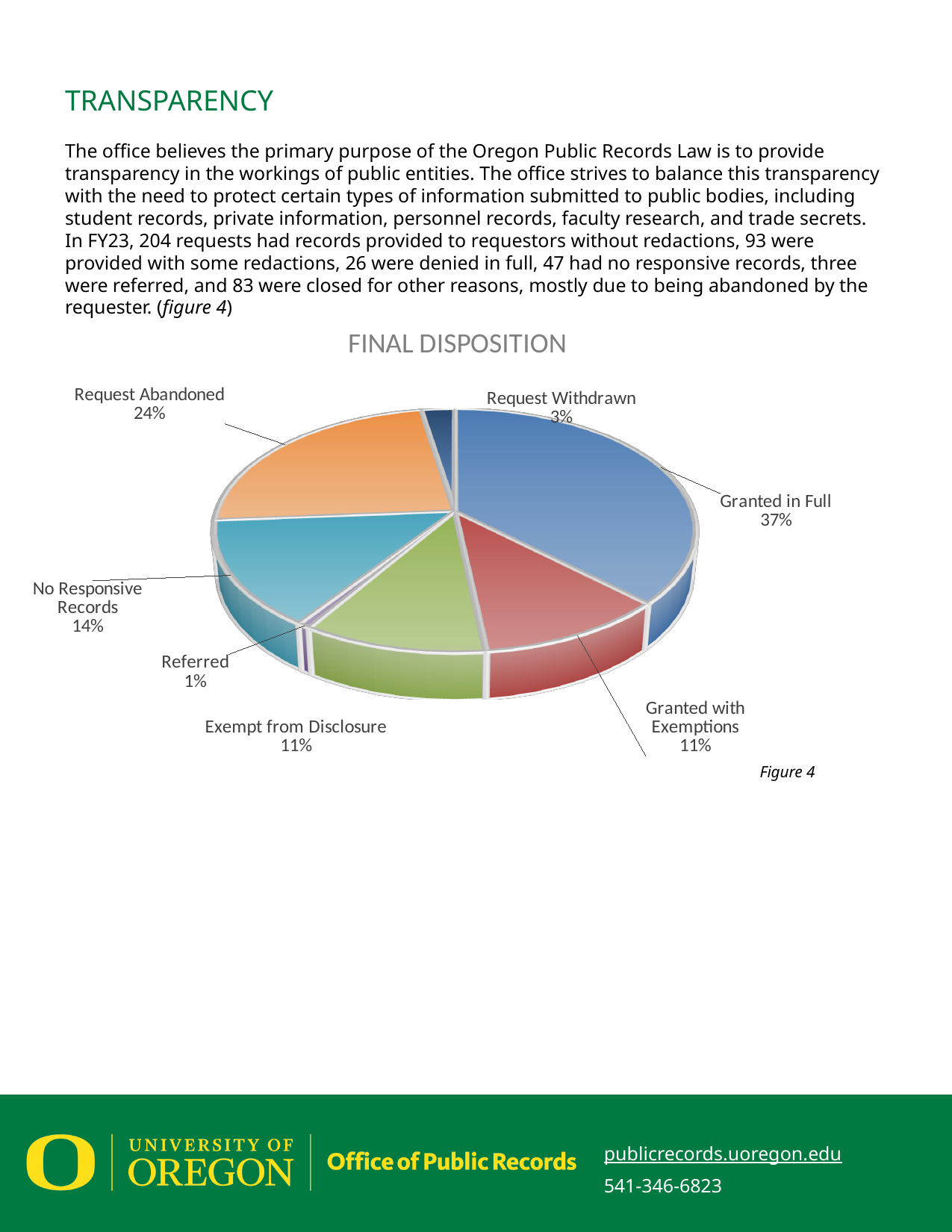
How many categories are shown in the pie chart? 7 What is the title of the pie chart? FINAL DISPOSITION What percentage is shown for "No Responsive Records"? 14% What percentage is shown for "Request Abandoned"? 24% Which is larger, the share for "No Responsive Records" or the share for "Exempt from Disclosure"? No Responsive Records What type of chart is shown under the title "FINAL DISPOSITION"? Pie chart Which category has the largest slice of the pie? Granted in Full What percentage is shown for "Referred"? 1% What percentage is shown for "Request Withdrawn"? 3% Which category has the smallest slice of the pie? Referred What is the difference in percentage points between "Granted in Full" and "Request Abandoned"? 13 What share of the pie is labelled "Granted in Full"? 37%